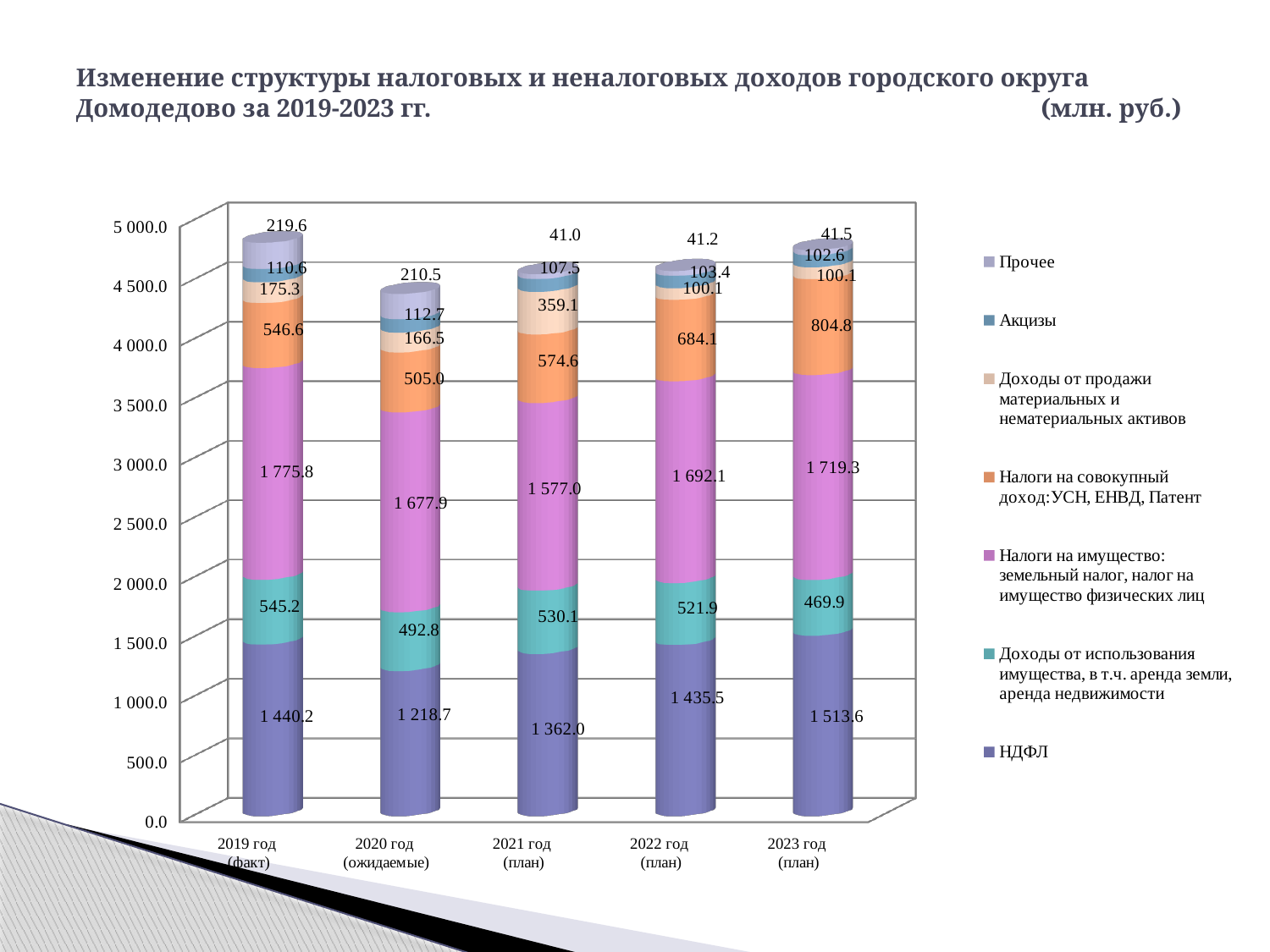
What is the difference between the Налоги на совокупный доход value for 2023 год (план) and for 2019 год (факт)? 258.2 What is the total of the stacked bar for 2019 год (факт)? 4 813.3 How many series does the legend list? 7 What is the value of Акцизы for 2020 год (ожидаемые)? 112.7 What kind of chart is shown on the slide? Stacked bar chart In which year is the value for Налоги на имущество the lowest? 2021 год (план) What is the value of НДФЛ for 2023 год (план)? 1 513.6 How many years (categories) are shown on the x axis? 5 Does the value for Налоги на совокупный доход rise or fall from 2020 год to 2023 год? Rise What is the value of Доходы от продажи материальных и нематериальных активов for 2021 год (план)? 359.1 In which year is the НДФЛ value the highest? 2023 год (план) Which is larger: Доходы от использования имущества in 2019 год (факт) or in 2022 год (план)? 2019 год (факт)